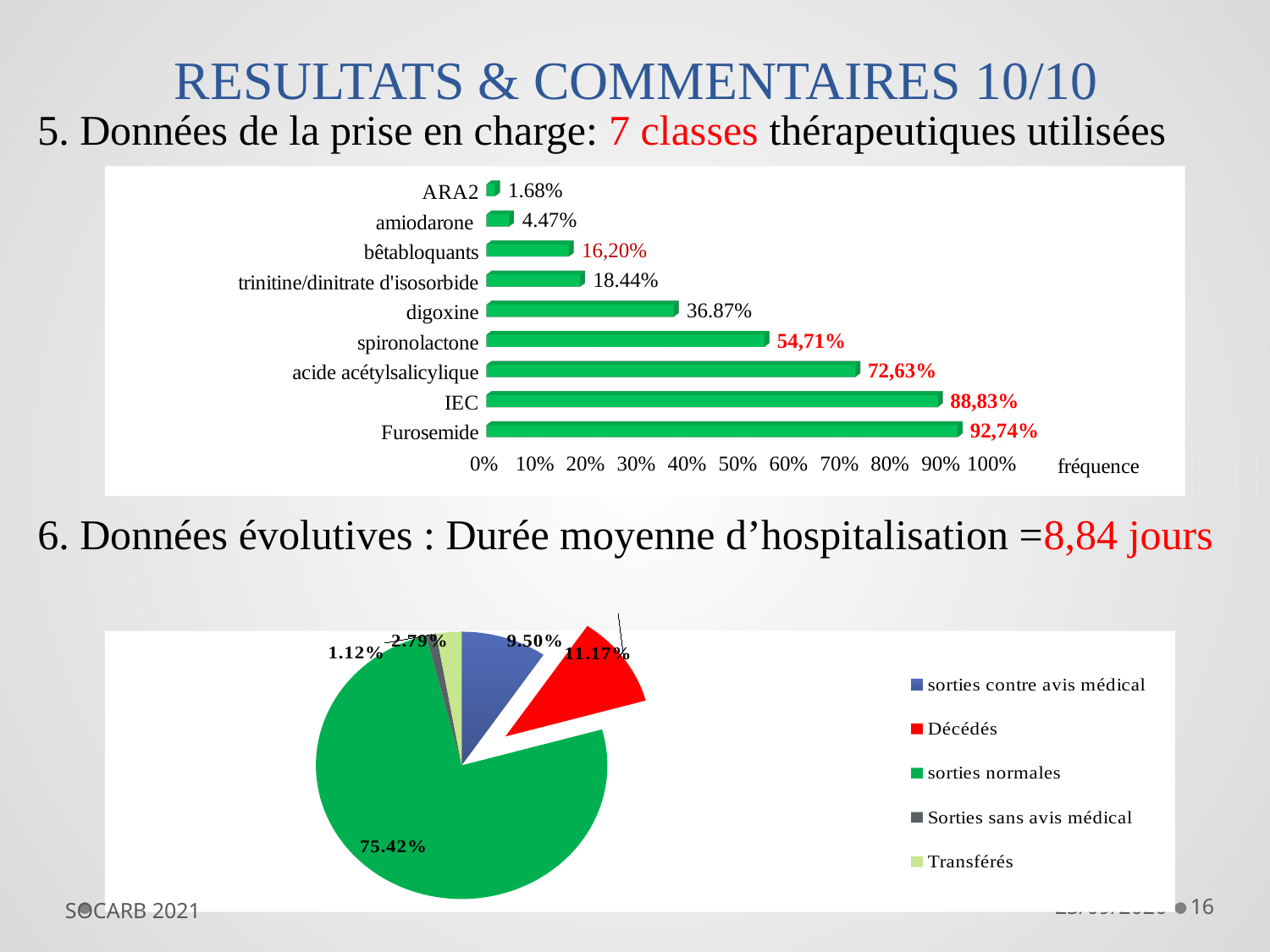
In the top bar chart, which category has the highest value? Furosemide In the top bar chart, which category has the lowest value? ARA2 In the bottom pie chart, what share is labelled for sorties normales? 75.42% In the top bar chart, what is the value for spironolactone? 54,71% How many entries does the legend of the bottom pie chart list? 5 In the bottom pie chart, what is the value for Décédés? 11.17% In the top bar chart, what is the difference between the values for digoxine and trinitine/dinitrate d'isosorbide? 18.43% In the top bar chart, which is larger, the value for IEC or the value for acide acétylsalicylique? IEC How many categories are shown in the top bar chart? 9 In the top bar chart, what is the value for digoxine? 36.87% In the bottom pie chart, what is the difference between the values for Décédés and sorties contre avis médical? 1.67% What kind of chart is the top chart on the slide? Bar chart